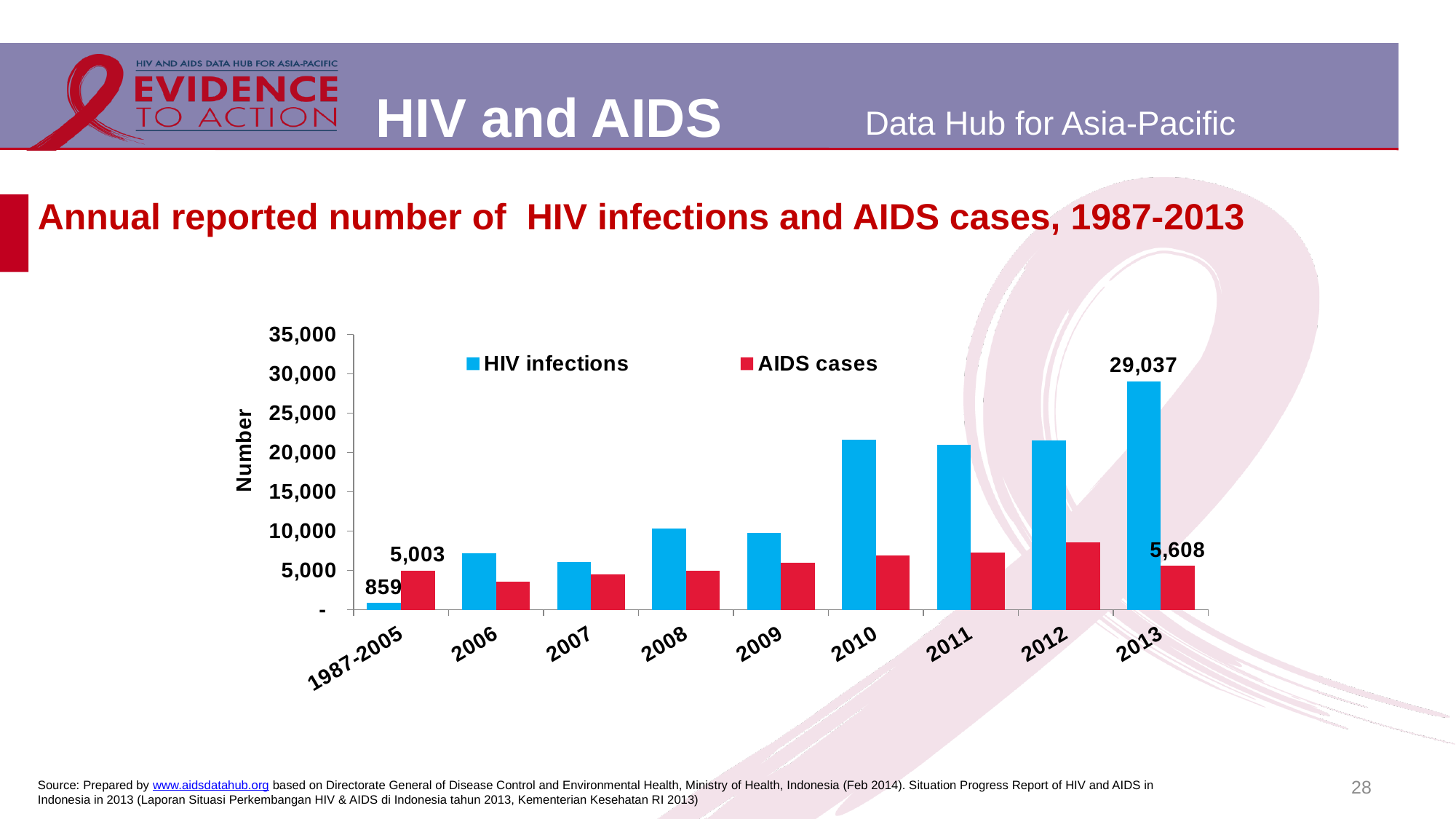
How many periods are shown on the x axis? 9 Which period has the highest number of HIV infections? 2013 What is the reported number of HIV infections for 1987-2005? 859 Which period has the lowest number of HIV infections? 1987-2005 In 2013, which is larger: HIV infections or AIDS cases? HIV infections How many series does the legend list? 2 Is the number of HIV infections in 2010 greater or less than 20,000? greater What is the reported number of HIV infections in 2013? 29,037 What is the reported number of AIDS cases in 2013? 5,608 Is the number of AIDS cases in 2012 greater or less than 10,000? less What is the reported number of AIDS cases for 1987-2005? 5,003 In 2013, how many more HIV infections than AIDS cases were reported? 23,429